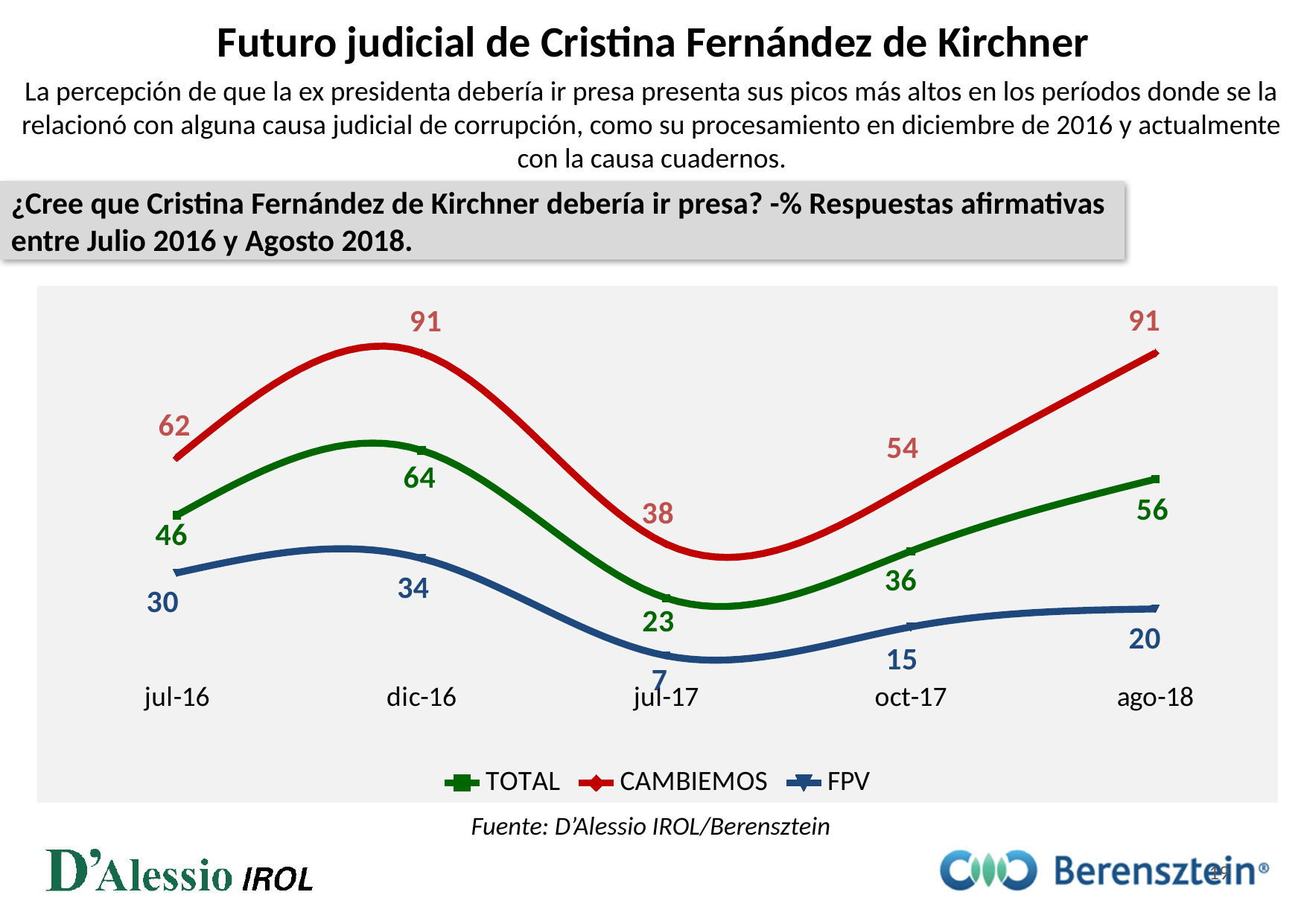
In which period is the FPV series highest? dic-16 Which colour is used for the FPV series? blue How many series does the legend list? 3 What is the difference between CAMBIEMOS and FPV in ago-18? 71 What is the value for CAMBIEMOS in dic-16? 91 In which period is the TOTAL series lowest? jul-17 What is the value for TOTAL in oct-17? 36 Does the CAMBIEMOS series rise or fall from jul-17 to ago-18? rise What is the value for FPV in jul-17? 7 How many time periods are shown on the x axis? 5 What kind of chart is shown on the slide? line chart Which is larger in jul-16: the TOTAL value or the FPV value? TOTAL